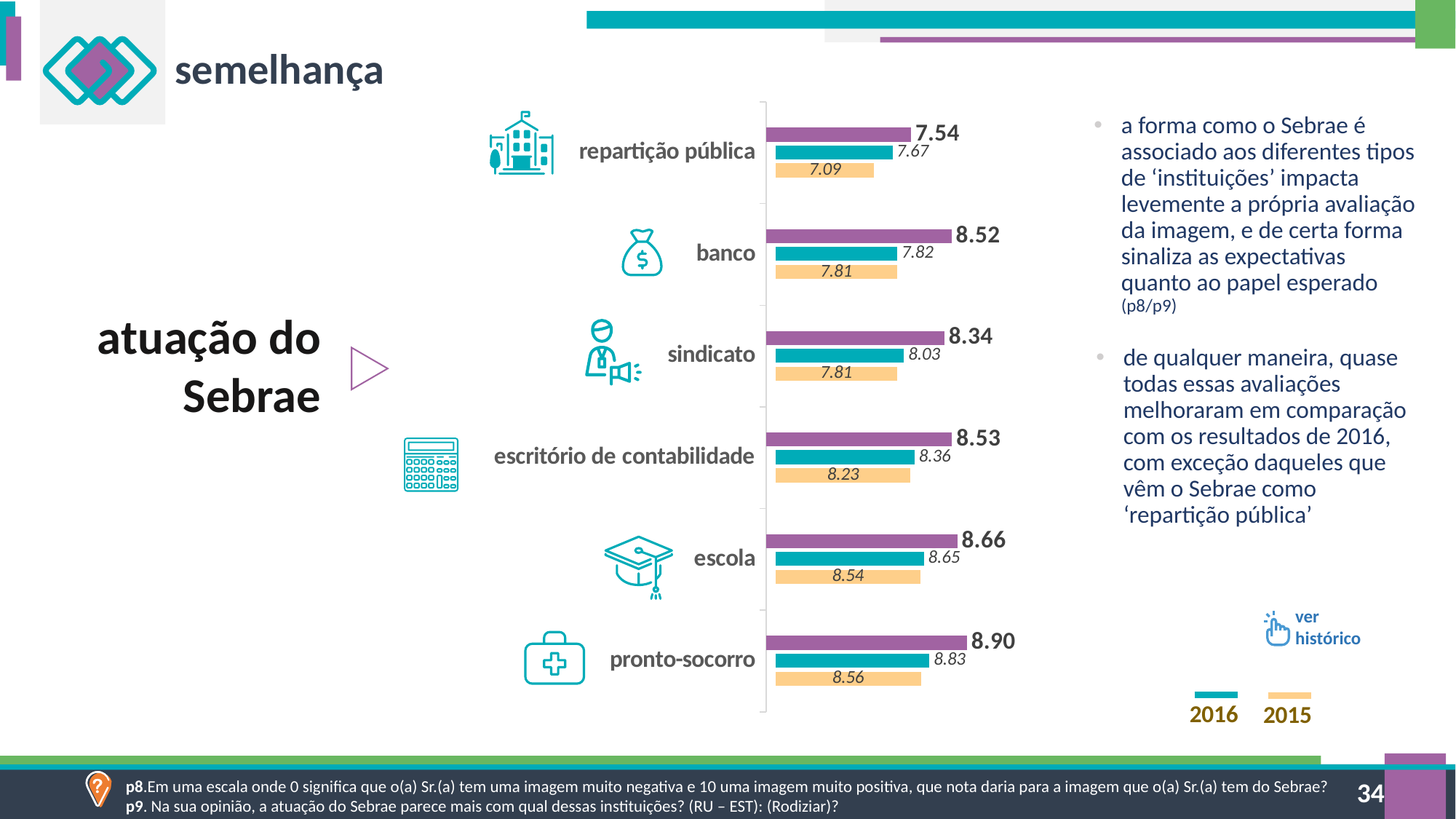
Which category has the highest 2015 value? pronto-socorro What is the 2015 value for escola? 8.54 What is the value shown on the purple bar for pronto-socorro? 8.90 Which category has the lowest 2016 value? repartição pública Which has the larger 2016 value, banco or sindicato? sindicato How many series does the legend list? 2 What is the 2016 value for banco? 7.82 What kind of chart is shown on the slide? bar chart How many categories are shown in the chart? 6 What is the difference between the purple bar value and the 2016 value for sindicato? 0.31 What is the difference between the 2016 and 2015 values for repartição pública? 0.58 What is the 2015 value for escritório de contabilidade? 8.23